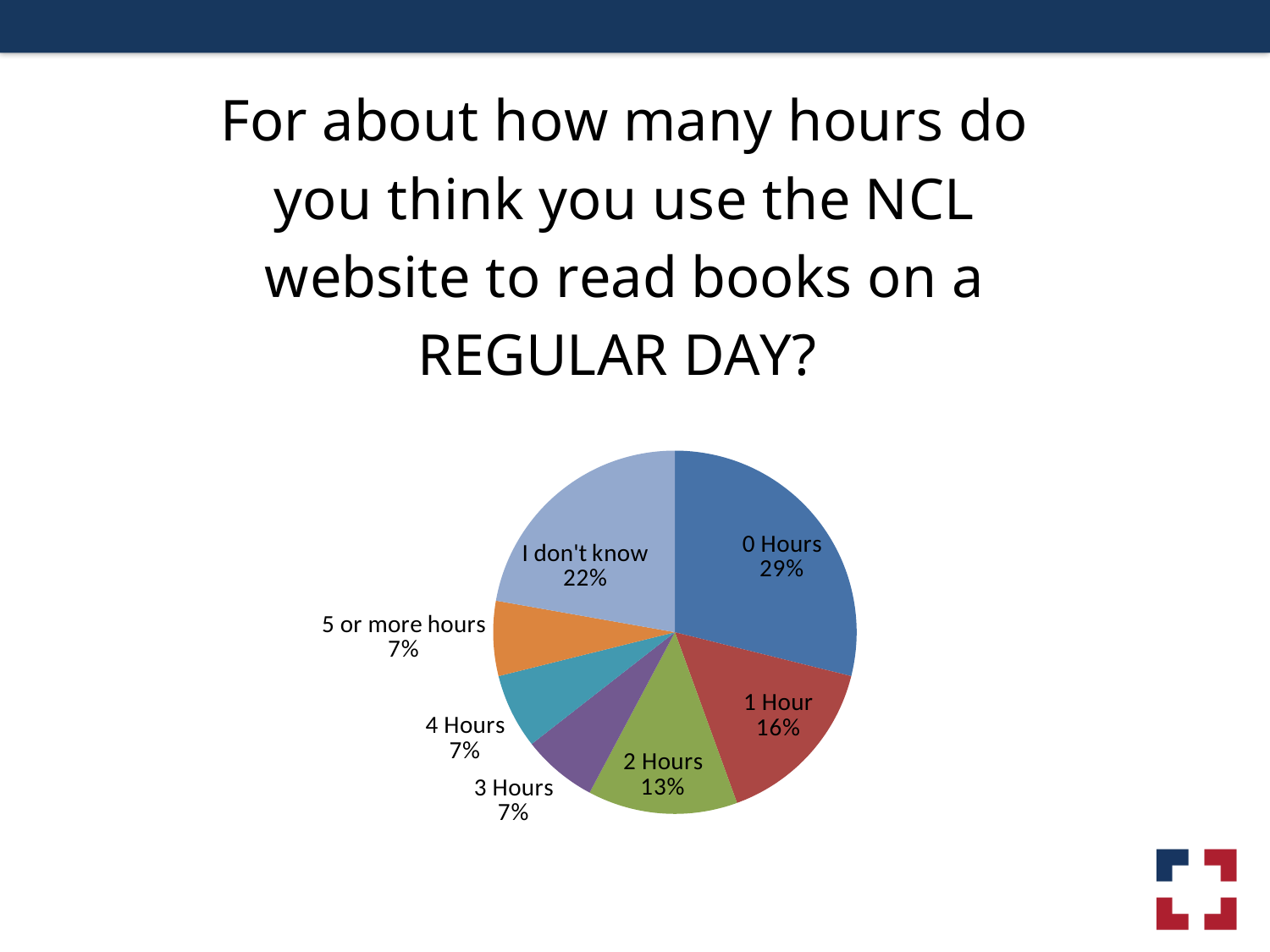
What kind of chart is shown on the slide? pie chart What percentage of respondents answered "2 Hours"? 13% How many categories share the same value of 7%? 3 Which category has the largest share of the pie? 0 Hours What is the difference in percentage points between "I don't know" and "2 Hours"? 9 What percentage of respondents answered "5 or more hours"? 7% What percentage of respondents answered "I don't know"? 22% What is the title of the chart on the slide? For about how many hours do you think you use the NCL website to read books on a REGULAR DAY? What percentage of respondents answered "0 Hours"? 29% Which is larger, the share for "1 Hour" or the share for "2 Hours"? 1 Hour How many categories (slices) does the pie chart have? 7 What is the difference in percentage points between "0 Hours" and "1 Hour"? 13